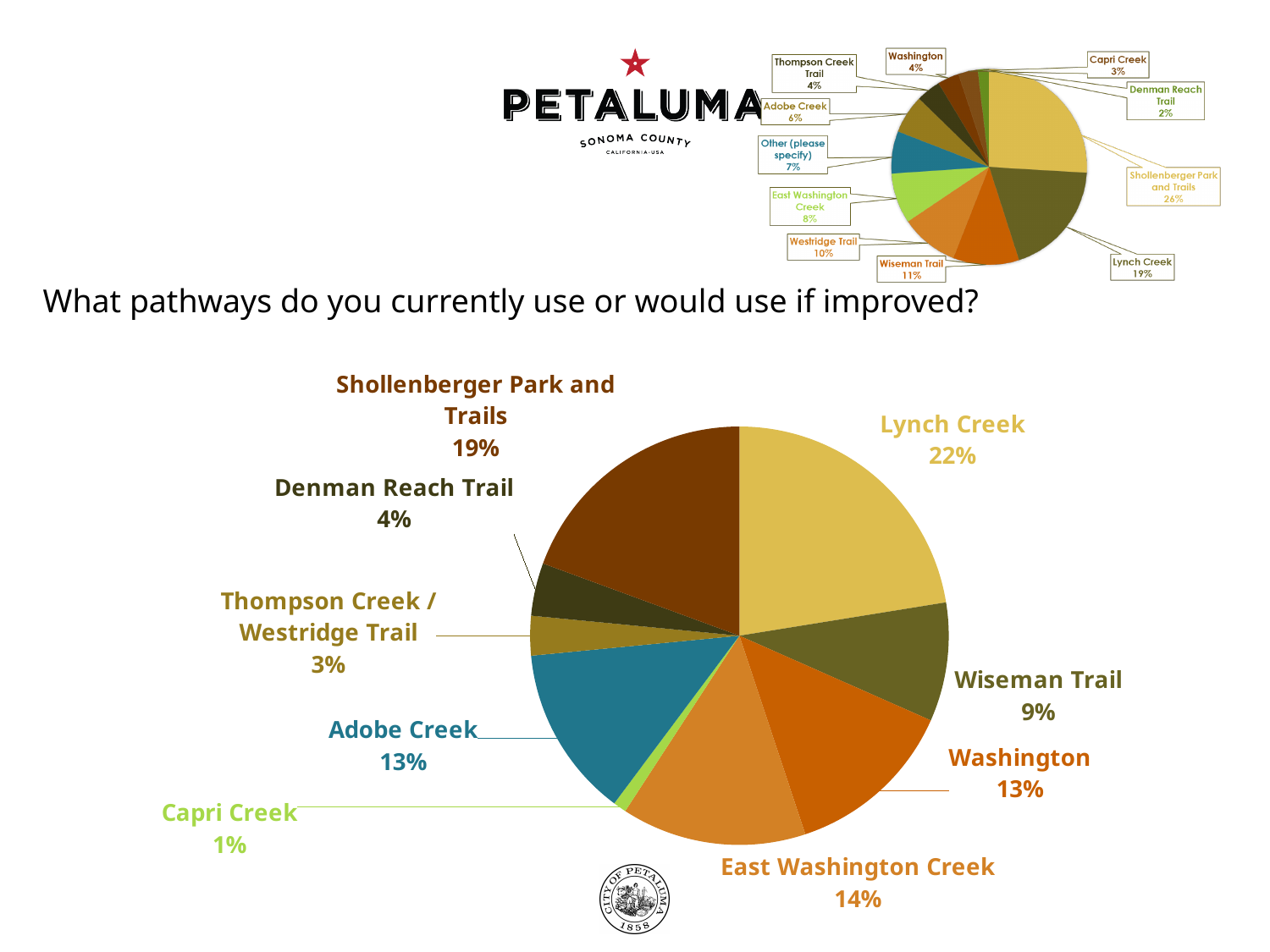
What type of chart is the large chart at the bottom of the slide? Pie chart In the large pie chart at the bottom of the slide, which has the larger share, Wiseman Trail or Washington? Washington In the small pie chart at the top right of the slide, which category has the smallest share? Denman Reach Trail How many categories are shown in the small pie chart at the top right of the slide? 11 In the large pie chart at the bottom of the slide, which pathway has the smallest share? Capri Creek In the small pie chart at the top right of the slide, what is the difference between the shares for Lynch Creek and Wiseman Trail? 8% In the large pie chart at the bottom of the slide, what share is shown for Lynch Creek? 22% In the large pie chart at the bottom of the slide, what share is shown for East Washington Creek? 14% In the small pie chart at the top right of the slide, what share is shown for Shollenberger Park and Trails? 26% In the large pie chart at the bottom of the slide, what is the difference between the shares for Lynch Creek and Shollenberger Park and Trails? 3% How many pathway categories are shown in the large pie chart at the bottom of the slide? 9 In the large pie chart at the bottom of the slide, which pathway has the largest share? Lynch Creek